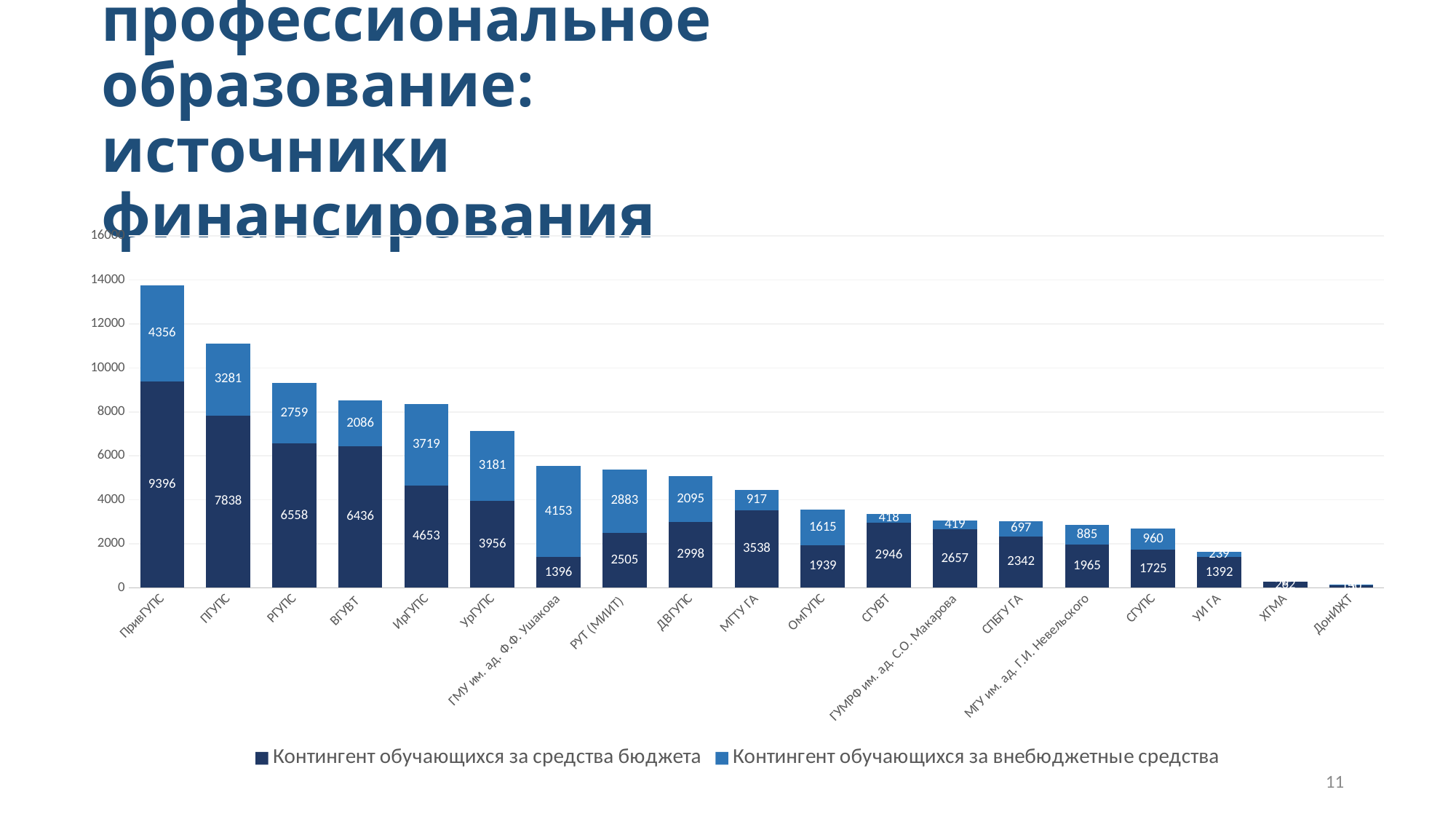
What is the difference between the 'Контингент обучающихся за средства бюджета' values for ПГУПС and РГУПС? 1280 What is the total height of the stacked bar for ПГУПС? 11119 What is the total height of the stacked bar for ДВГУПС? 5093 How many series does the legend list? 2 Which category has the highest value for 'Контингент обучающихся за внебюджетные средства'? ПривГУПС What is the value of 'Контингент обучающихся за внебюджетные средства' for ИрГУПС? 3719 What is the value of 'Контингент обучающихся за средства бюджета' for РУТ (МИИТ)? 2505 What is the value of 'Контингент обучающихся за средства бюджета' for ПривГУПС? 9396 Which is larger for ГМУ им. ад. Ф.Ф. Ушакова: the budget-funded contingent or the extra-budgetary contingent? Контингент обучающихся за внебюджетные средства What kind of chart is shown on the slide? Stacked bar chart Is the total stacked value for ПривГУПС greater or less than 12000? greater